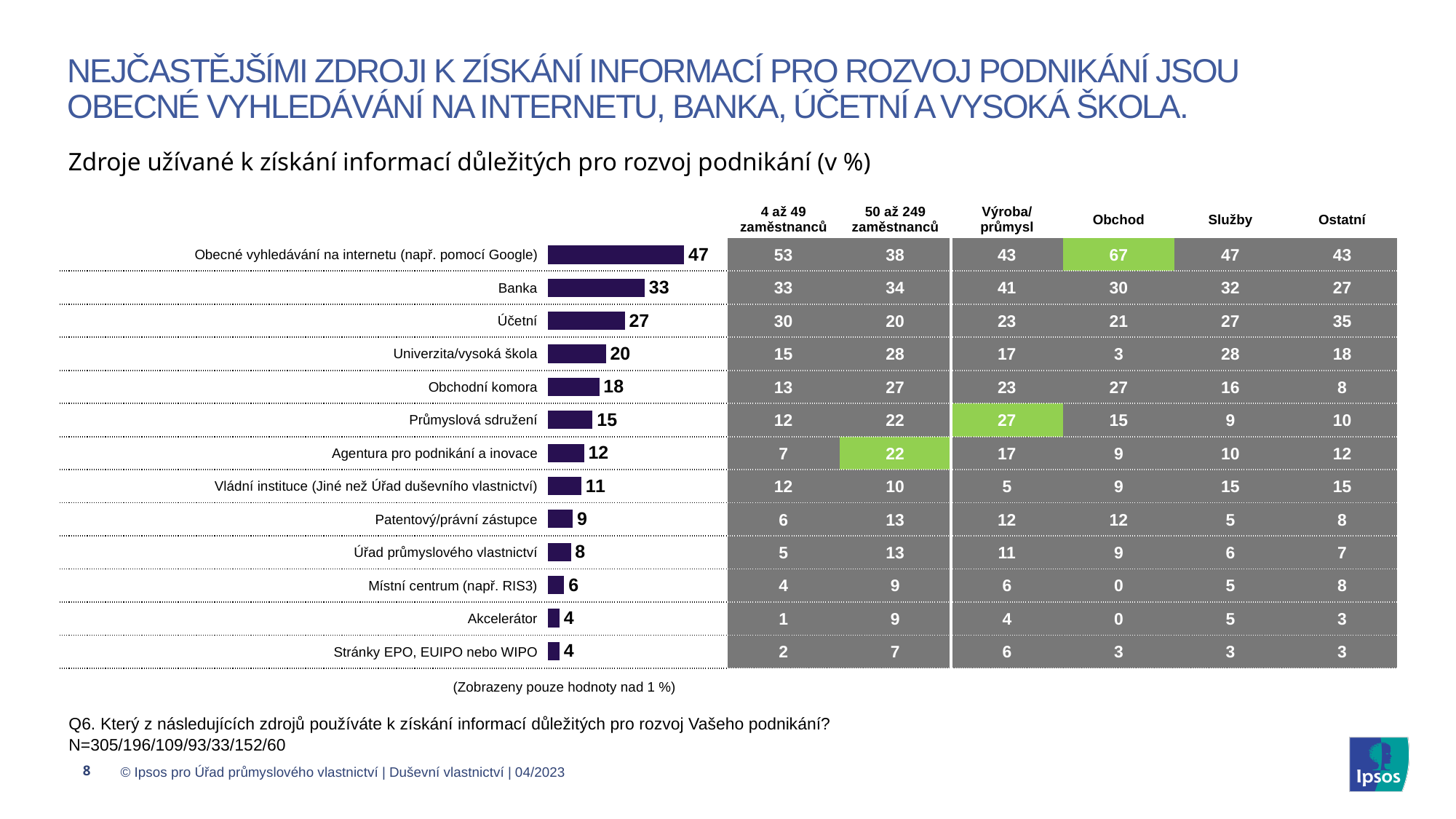
What is the difference between the values for "Účetní" and "Obchodní komora" in the bar chart? 9 Which has a larger value in the bar chart, "Průmyslová sdružení" or "Agentura pro podnikání a inovace"? Průmyslová sdružení What value is shown for "Banka" in the bar chart? 33 Which has a larger value in the bar chart, "Patentový/právní zástupce" or "Místní centrum (např. RIS3)"? Patentový/právní zástupce What is the subtitle describing the data in the chart? Zdroje užívané k získání informací důležitých pro rozvoj podnikání (v %) What value is shown for "Úřad průmyslového vlastnictví" in the bar chart? 8 How many categories are shown in the bar chart? 13 Which category has the highest value in the bar chart? Obecné vyhledávání na internetu (např. pomocí Google) What is the difference between the values for "Obecné vyhledávání na internetu (např. pomocí Google)" and "Banka" in the bar chart? 14 What kind of chart is shown on the slide? Bar chart What value is shown for "Univerzita/vysoká škola" in the bar chart? 20 What value is shown for "Akcelerátor" in the bar chart? 4